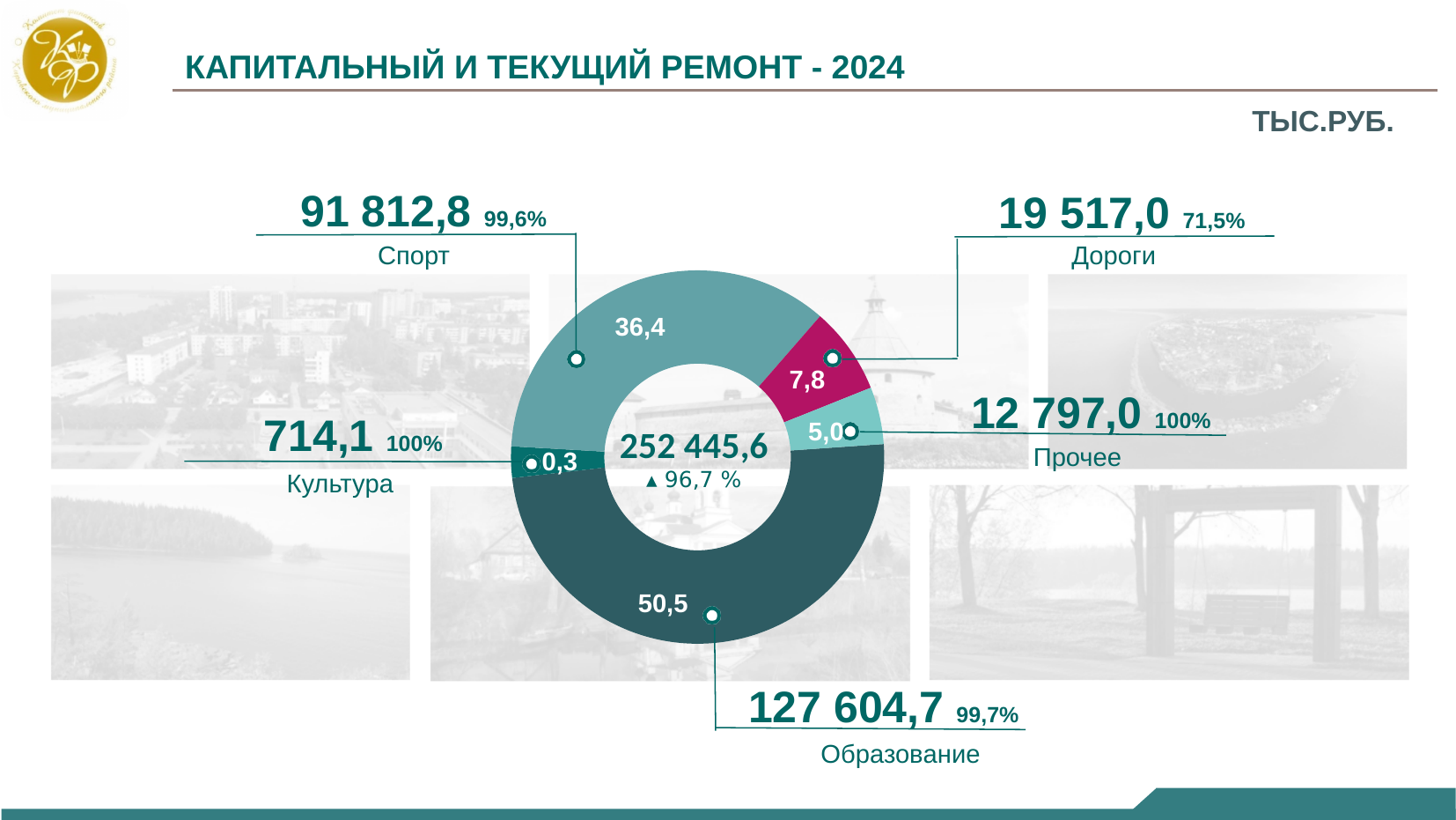
Which category has the smallest value? Культура Which is larger, the value for Дороги or the value for Прочее? Дороги What is the value for Спорт in thousand rubles? 91 812,8 What total value is shown in the centre of the donut chart? 252 445,6 What is the value for Дороги in thousand rubles? 19 517,0 Which category has the largest value? Образование What kind of chart is shown on the slide? Pie (donut) chart What is the value for Образование in thousand rubles? 127 604,7 How many categories does the donut chart show? 5 What share of the donut does Образование take? 50,5 What share of the donut does Прочее take? 5,0 What execution percentage is shown next to Дороги? 71,5%